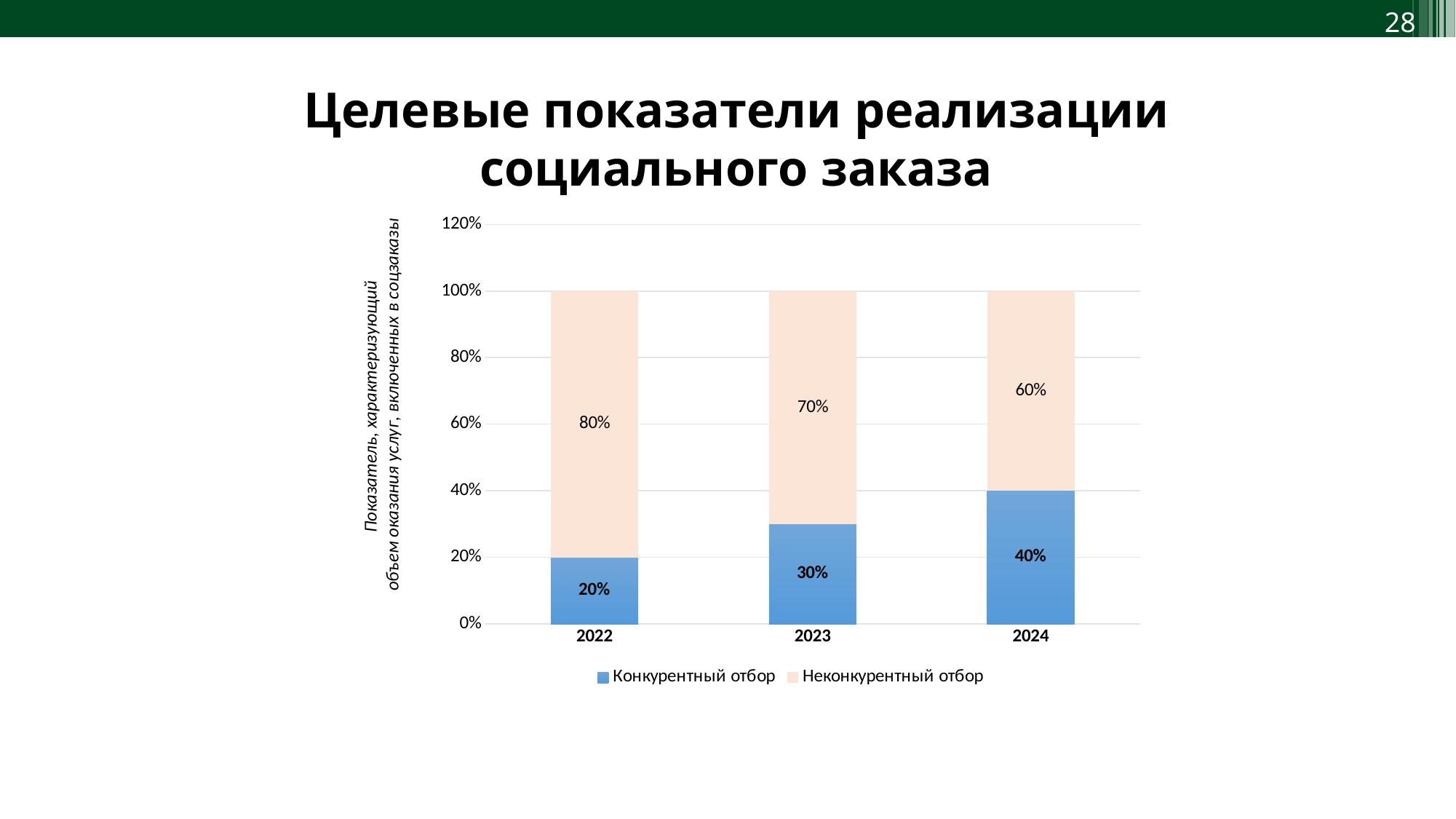
What is the value for Неконкурентный отбор in 2022? 80% In which year is Конкурентный отбор highest? 2024 What is the total of the stacked bar for 2023? 100% What is the value for Конкурентный отбор in 2024? 40% In which year is Неконкурентный отбор lowest? 2024 What is the difference between Конкурентный отбор in 2024 and in 2022? 20% How many years are shown on the x axis? 3 How many series does the legend list? 2 Does Конкурентный отбор rise or fall from 2022 to 2024? rise Which is larger in 2023: Конкурентный отбор or Неконкурентный отбор? Неконкурентный отбор What is the value for Неконкурентный отбор in 2023? 70% What is the value for Конкурентный отбор in 2022? 20%